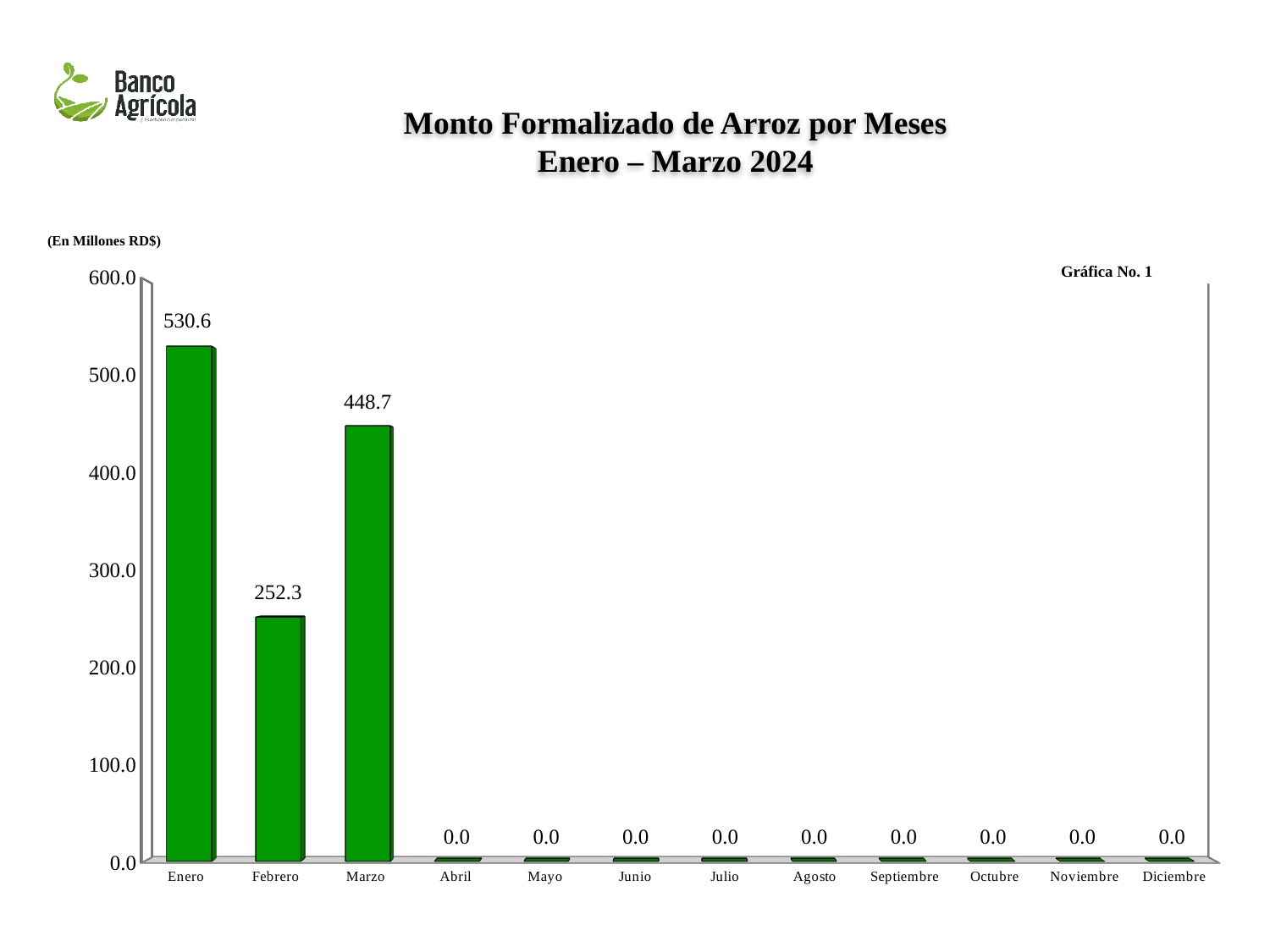
What is the difference between the values for Marzo and Febrero? 196.4 Which is larger, the value for Febrero or the value for Marzo? Marzo What is the value for Abril? 0.0 Is the value for Enero greater or less than 500.0? greater What kind of chart is shown on the slide? bar chart What is the difference between the values for Enero and Marzo? 81.9 What is the value for Marzo? 448.7 Which month has the highest value? Enero How many months are shown on the x axis? 12 What is the value for Enero? 530.6 What is the value for Febrero? 252.3 What unit is stated for the values in the chart? En Millones RD$